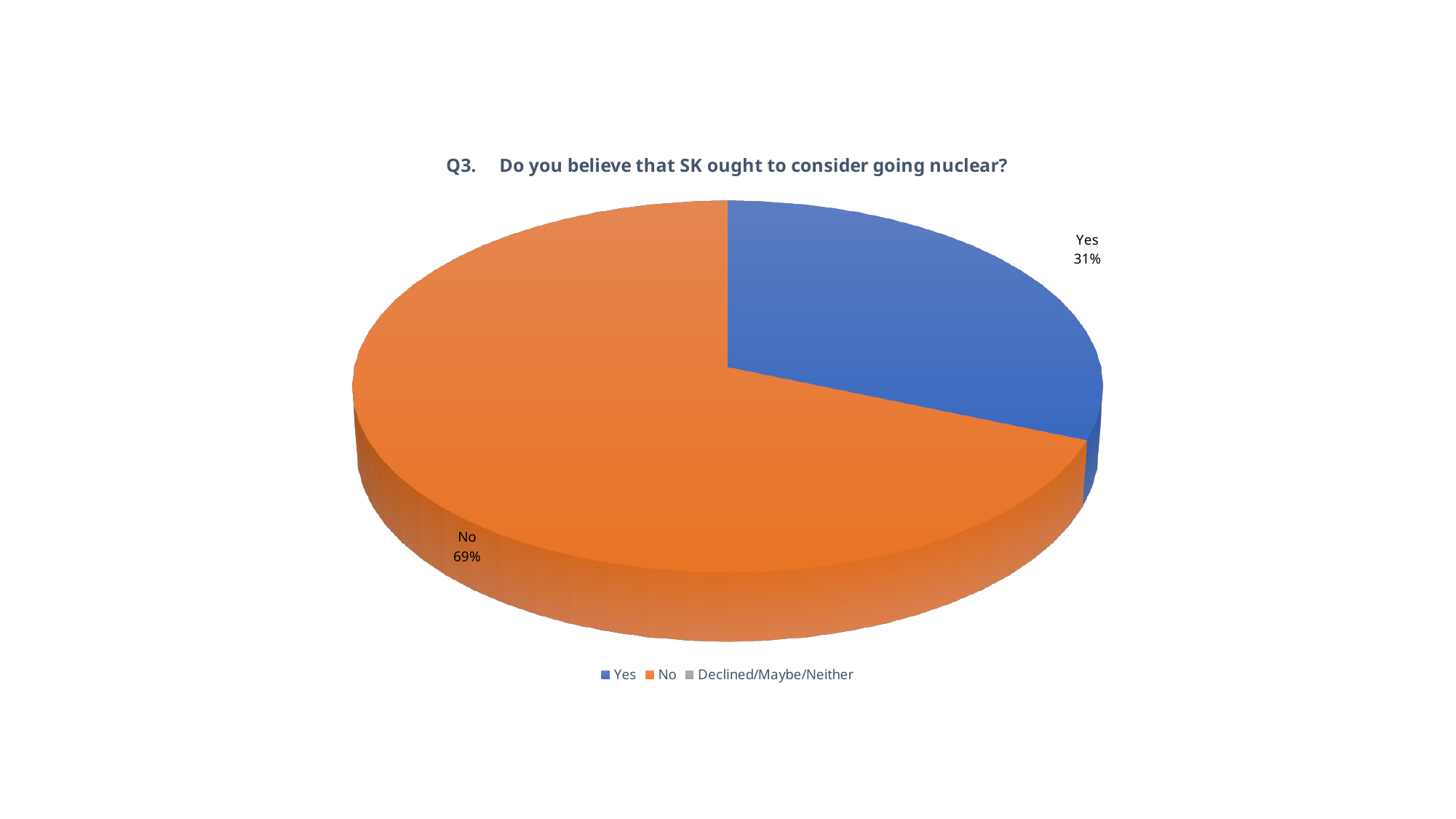
What kind of chart is shown on the slide? Pie chart How many entries does the legend list? 3 What is the third legend entry, after Yes and No? Declined/Maybe/Neither What percentage of respondents answered Yes? 31% What is the title of the chart? Q3. Do you believe that SK ought to consider going nuclear? Which of the two labelled slices is smaller, Yes or No? Yes What colour is the Yes slice? Blue What percentage of respondents answered No? 69% Is the share for No larger than the share for Yes? Yes What is the difference in percentage points between the No and Yes slices? 38 Which response has the largest share of the pie? No